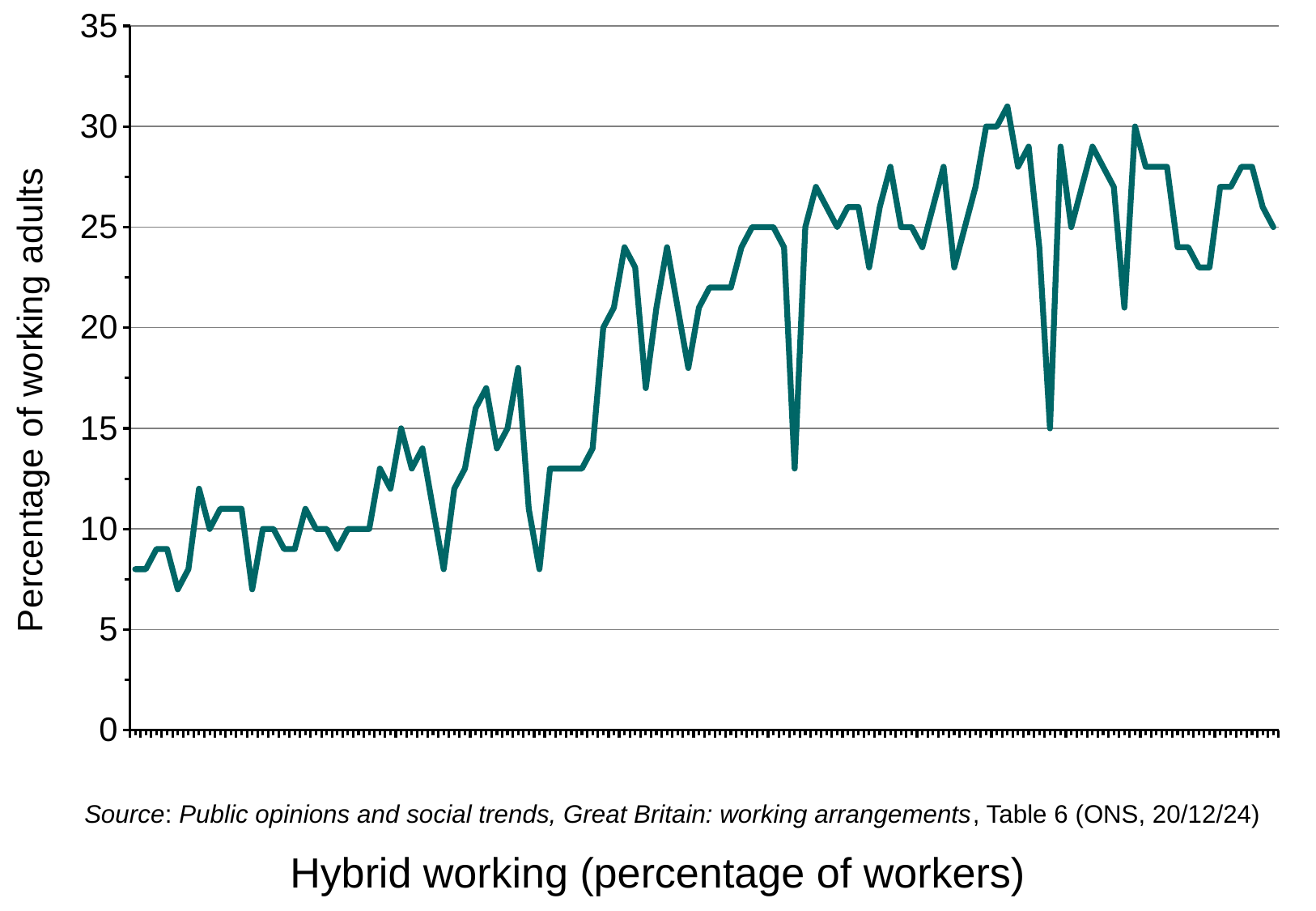
How many lines are plotted on the chart? 1 Overall, do the values rise or fall from left to right along the x axis? Rise What is the title of the chart? Hybrid working (percentage of workers) What kind of chart is shown on the slide? Line chart Is the lowest point on the line greater or less than 10? less Is the value at the rightmost point of the line greater or less than 20? greater What is the label on the vertical axis? Percentage of working adults Is the highest point on the line greater or less than 30? greater Is the value at the rightmost point of the line greater or less than the value at the leftmost point? greater